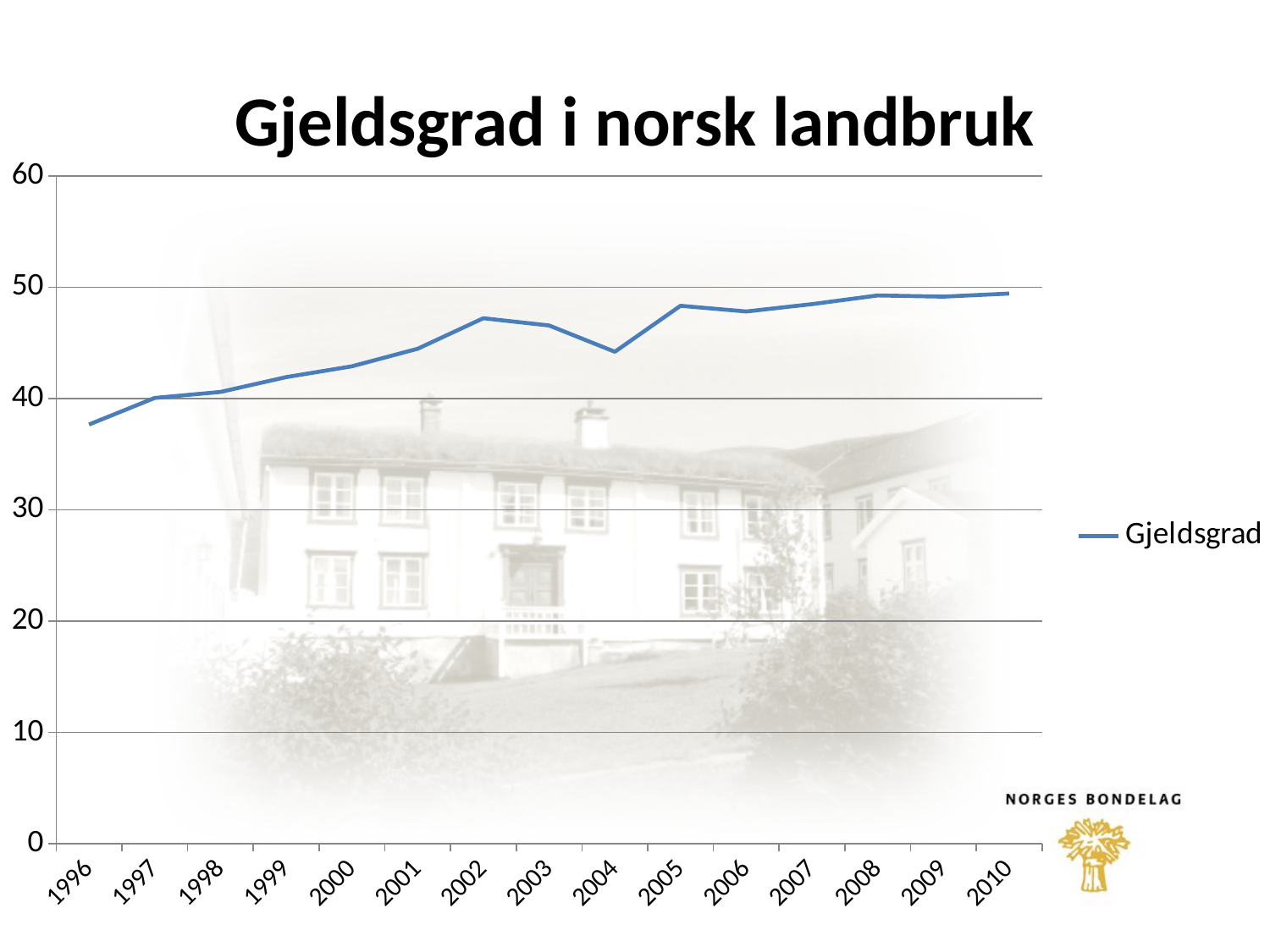
Is the value for Gjeldsgrad in 2010 greater or less than 50? less How many series does the legend list? 1 Which year has the lowest value for Gjeldsgrad? 1996 What is the title of the chart? Gjeldsgrad i norsk landbruk Which year has the larger value for Gjeldsgrad, 2002 or 2004? 2002 Is the value for Gjeldsgrad in 1996 greater or less than 40? less What is the name of the series shown in the legend? Gjeldsgrad Which year has the larger value for Gjeldsgrad, 1996 or 2010? 2010 Is the value for Gjeldsgrad in 2002 greater or less than 40? greater How many years are plotted along the x axis? 15 Does the value for Gjeldsgrad generally rise or fall from 1996 to 2010? rise What kind of chart is shown on the slide? line chart